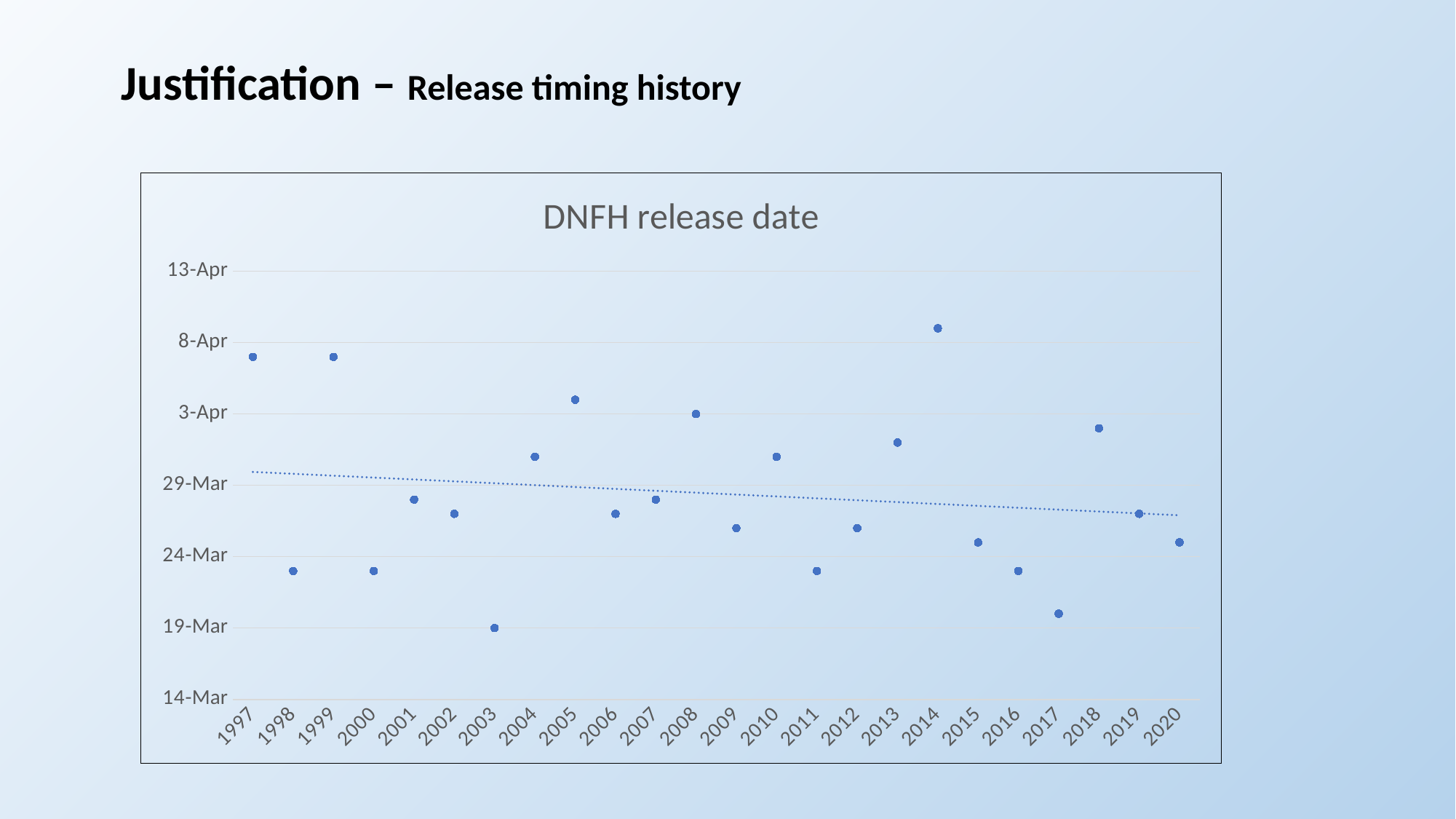
What is the release date plotted for 2003? 19-Mar Is the release date for 2014 later or earlier than 8-Apr? later What is the release date plotted for 2008? 3-Apr Is the release date for 2005 later or earlier than 3-Apr? later Is the release date for 2017 later or earlier than 24-Mar? earlier Does the dotted trend line in the chart rise or fall from 1997 to 2020? fall What kind of chart is shown on the slide? scatter chart Which year has the earliest (lowest) release date in the chart? 2003 How many years are plotted on the x axis of the chart? 24 Which year has a later release date, 2014 or 2017? 2014 What is the title of the chart? DNFH release date Which year has the latest (highest) release date in the chart? 2014